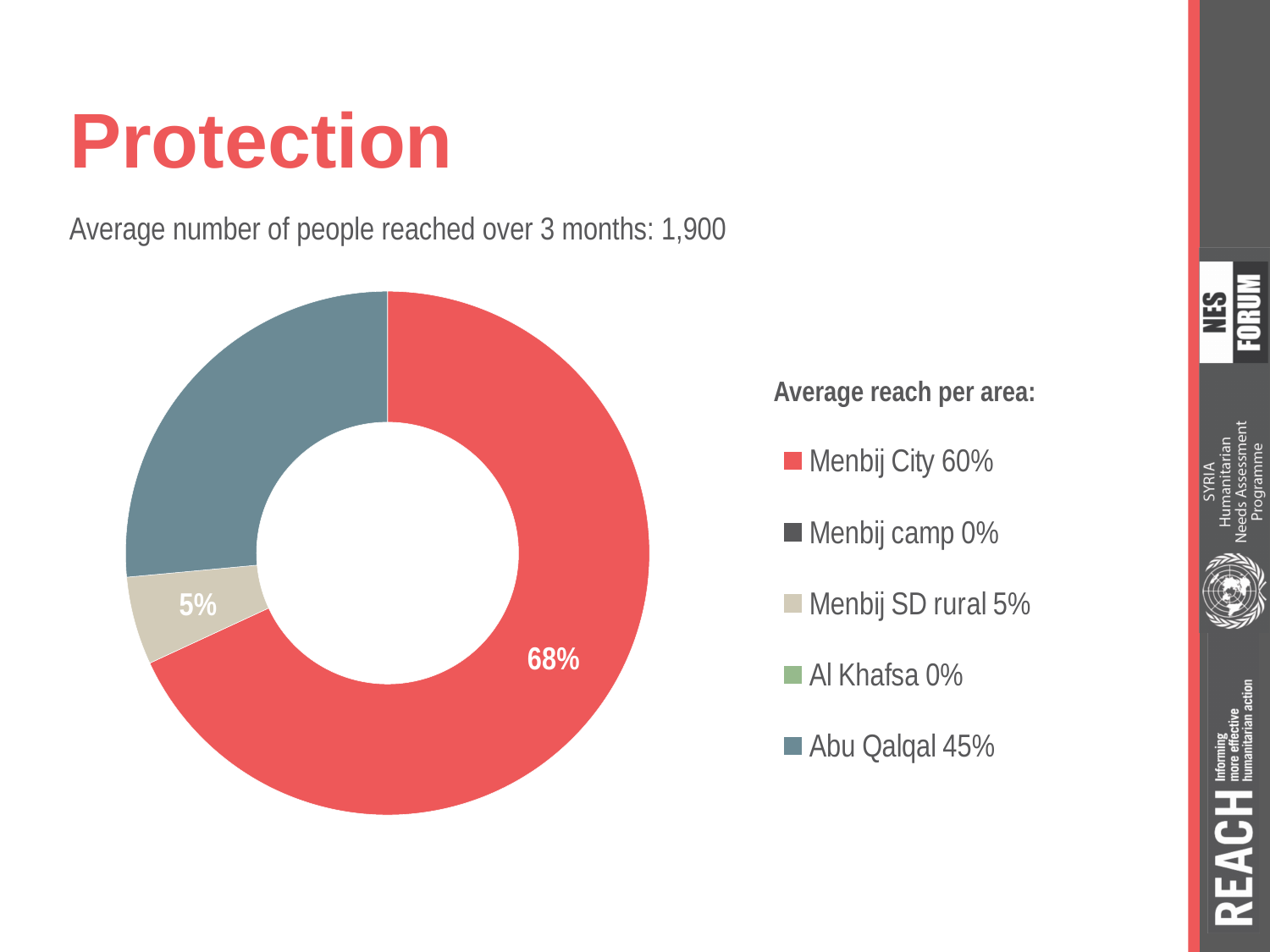
Is the slice for Abu Qalqal larger or smaller than the slice for Menbij SD rural? Larger What is the title of the slide containing the chart? Protection Which area has the largest slice in the donut chart? Menbij City How many entries does the legend of the chart list? 5 What percentage is shown on the red slice of the donut chart? 68% Is the slice for Abu Qalqal larger or smaller than the slice for Menbij City? Smaller What colour is the Menbij City slice in the donut chart? Red According to the legend, what is the average reach per area for Menbij City? 60% According to the legend, what is the average reach per area for Abu Qalqal? 45% Which of the two labelled slices is larger, the 68% slice or the 5% slice? The 68% slice (Menbij City) What kind of chart is shown on the slide? Pie (donut) chart What percentage is shown on the beige slice of the donut chart? 5%